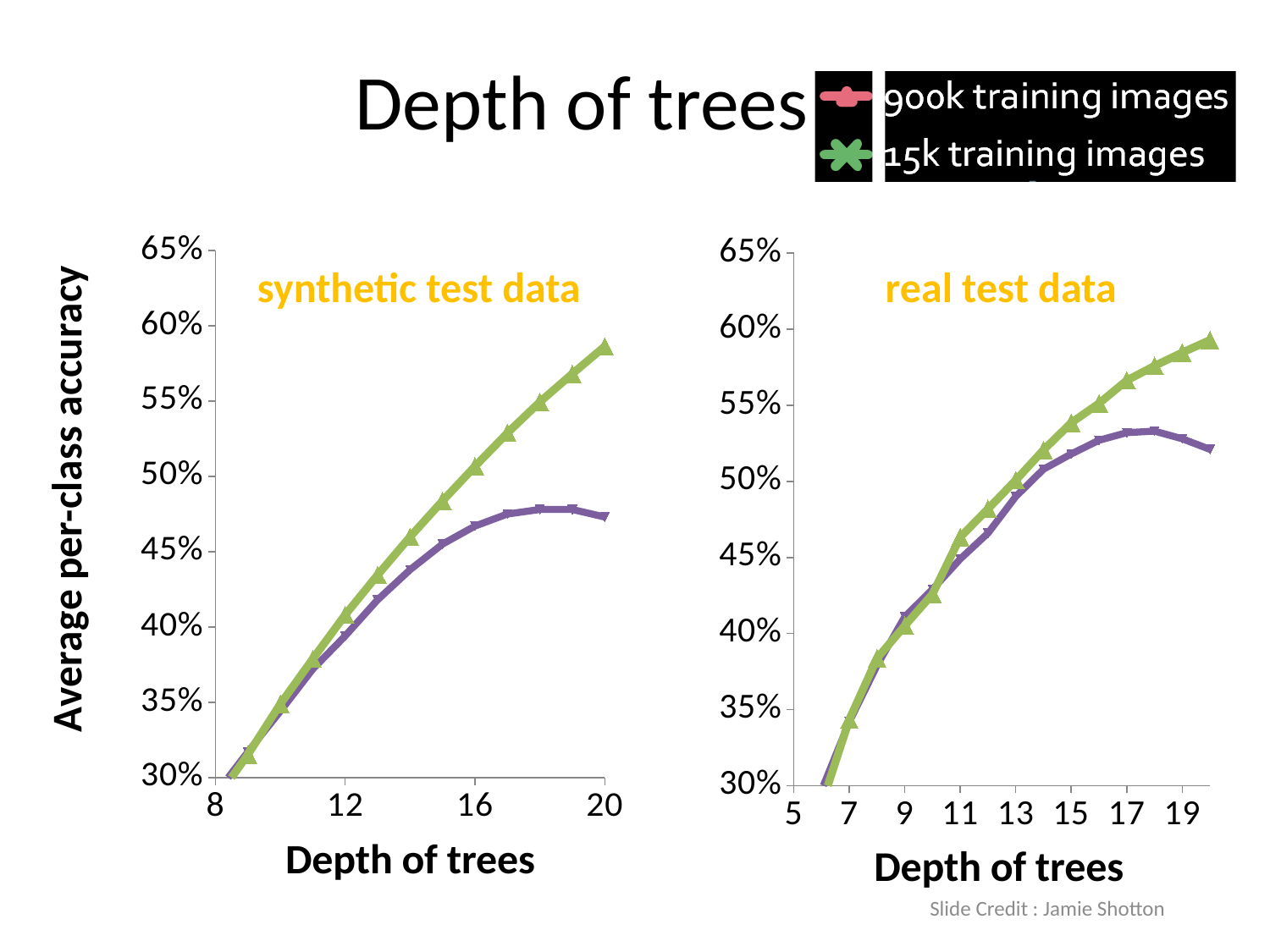
How many series does the legend at the top of the slide list? 2 In the 'synthetic test data' chart, which line is higher at depth 20, the green (15k training images) line or the purple line? the green (15k training images) line In the 'synthetic test data' chart, does the green (15k training images) line rise or fall as depth of trees increases? rise What are the two series named in the legend? 900k training images and 15k training images In the 'real test data' chart, does the purple line rise or fall between depth 18 and depth 20? fall In the 'real test data' chart, is the value of the green (15k training images) line at depth 19 greater or less than 55%? greater In the 'synthetic test data' chart, is the value of the green (15k training images) line at depth 20 greater or less than 55%? greater What is the label on the y axis shared by the two charts? Average per-class accuracy In the 'synthetic test data' chart, is the value of the green (15k training images) line at depth 16 greater or less than 45%? greater What kind of chart is the 'synthetic test data' chart? line chart